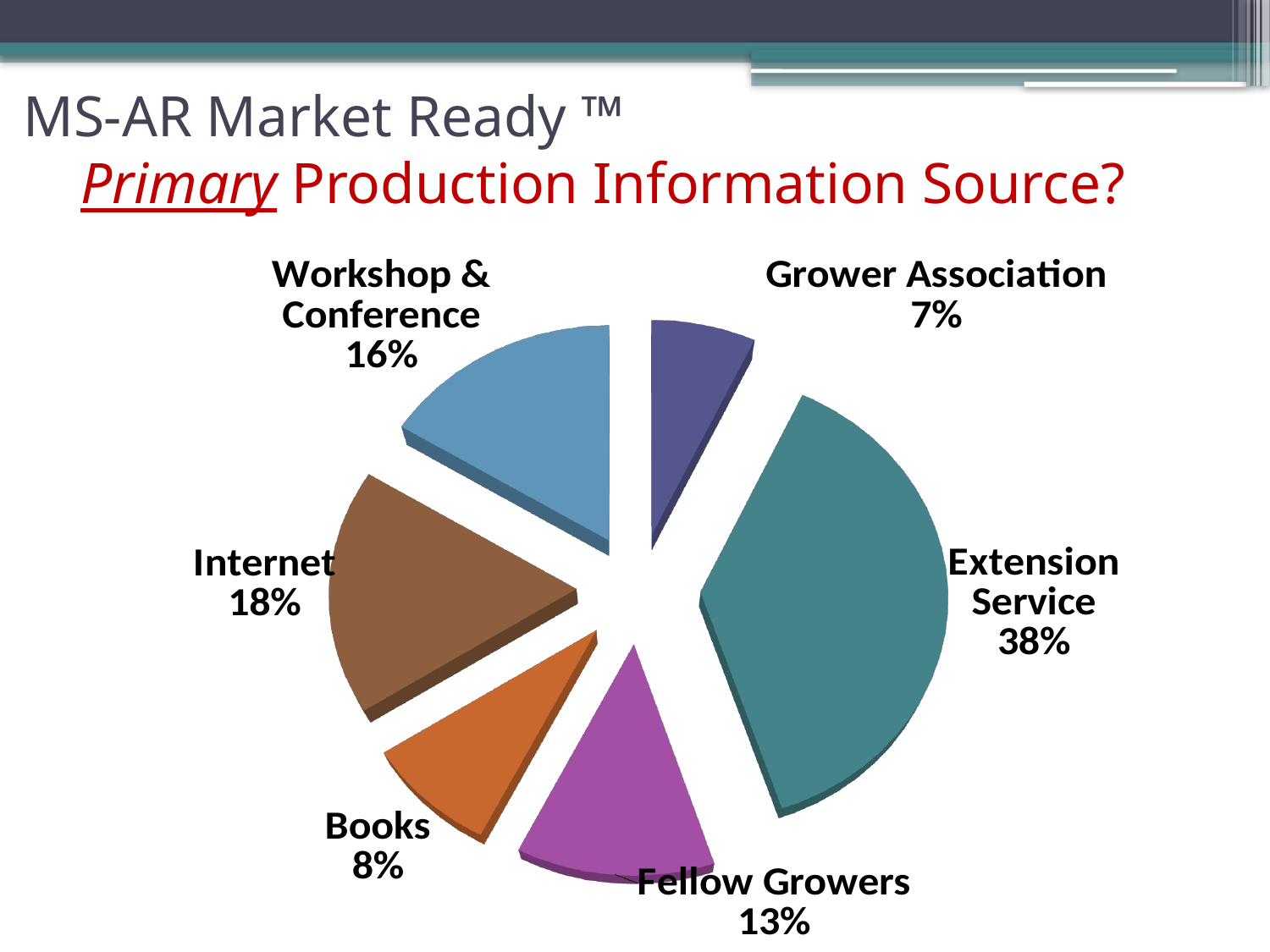
What is the combined share of Books and Grower Association? 15% What percentage is shown for Books? 8% Which is larger, the share for Internet or the share for Workshop & Conference? Internet What percentage is shown for Internet? 18% Which category has the largest slice of the pie? Extension Service What is the difference in percentage points between Extension Service and Internet? 20 How many categories are shown in the pie chart? 6 What percentage is shown for Fellow Growers? 13% What share of the pie does Extension Service account for? 38% Which category has the smallest slice of the pie? Grower Association What kind of chart is shown on the slide? Pie chart What percentage is shown for Workshop & Conference? 16%